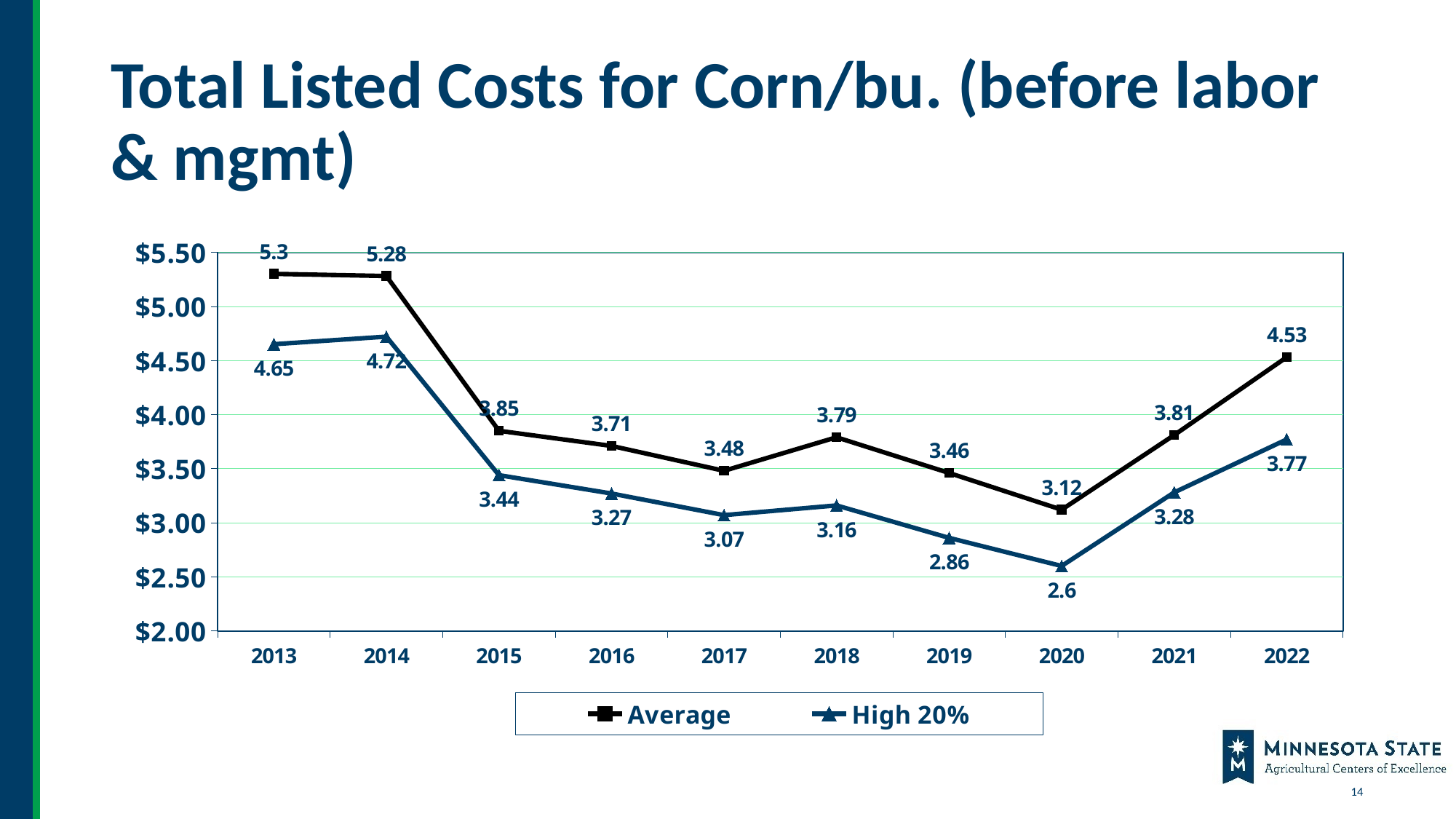
What is the High 20% value for 2017? 3.07 What is the High 20% value for 2020? 2.6 Does the Average series rise or fall from 2020 to 2022? Rise What is the difference between the Average and High 20% values in 2022? 0.76 What is the Average value for 2013? 5.3 What is the Average value for 2022? 4.53 How many series does the legend list? 2 What kind of chart is shown on the slide? Line chart How many years are shown on the x axis? 10 Which is larger, the Average value in 2018 or the Average value in 2019? 2018 In which year is the Average series at its lowest? 2020 In which year is the High 20% series at its highest? 2014